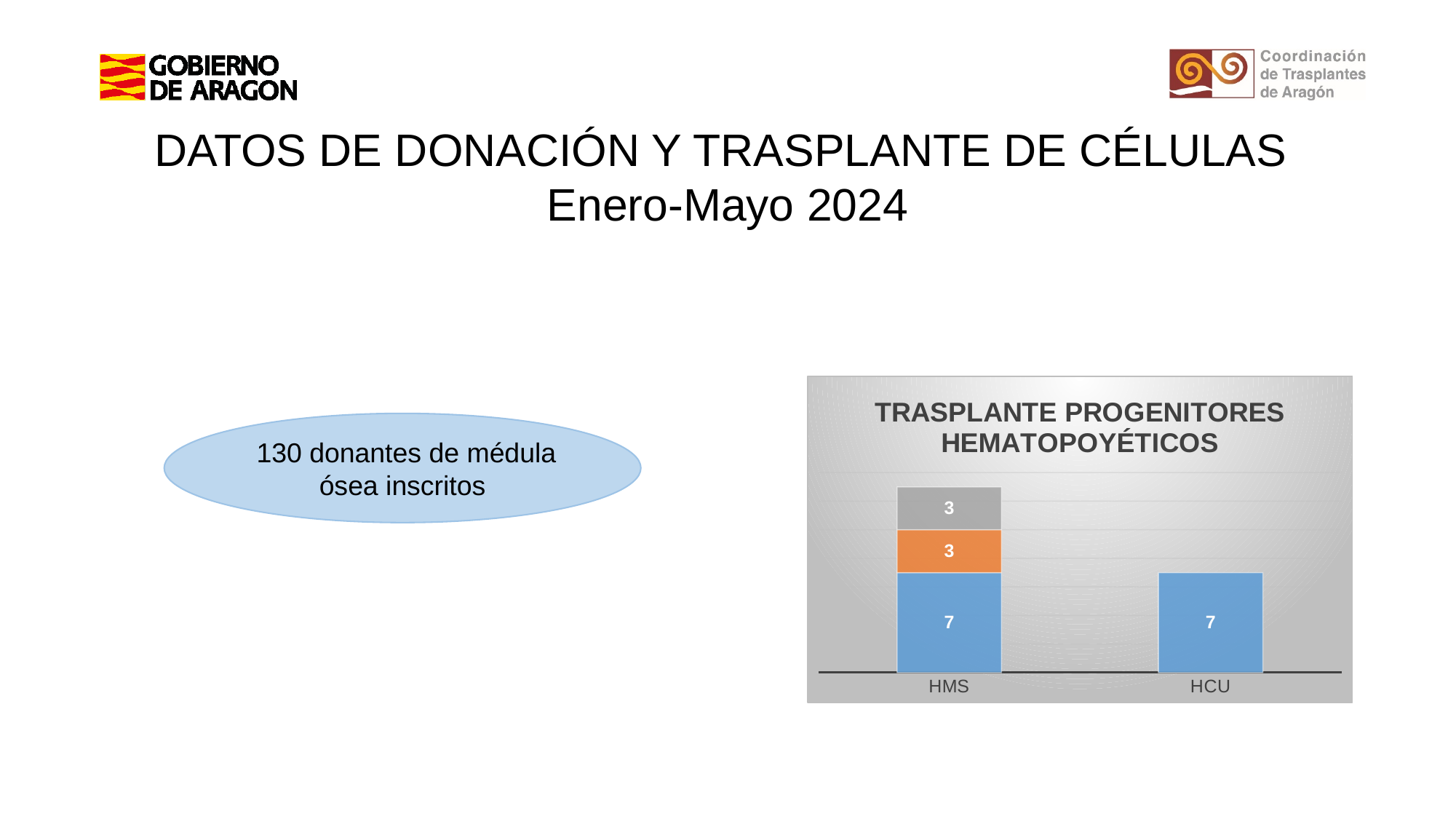
What is the value of the grey segment for HMS? 3 What is the title of the chart? TRASPLANTE PROGENITORES HEMATOPOYÉTICOS What kind of chart is shown on the slide? stacked bar chart What is the total of the stacked bar for HMS? 13 What is the value of the orange segment for HMS? 3 How many segments make up the HMS bar? 3 How many categories are shown on the x axis of the chart? 2 Which category has the higher total, HMS or HCU? HMS What is the value of the blue segment for HMS? 7 What is the value of the blue segment for HCU? 7 What is the difference between the total for HMS and the total for HCU? 6 What is the total of the stacked bar for HCU? 7